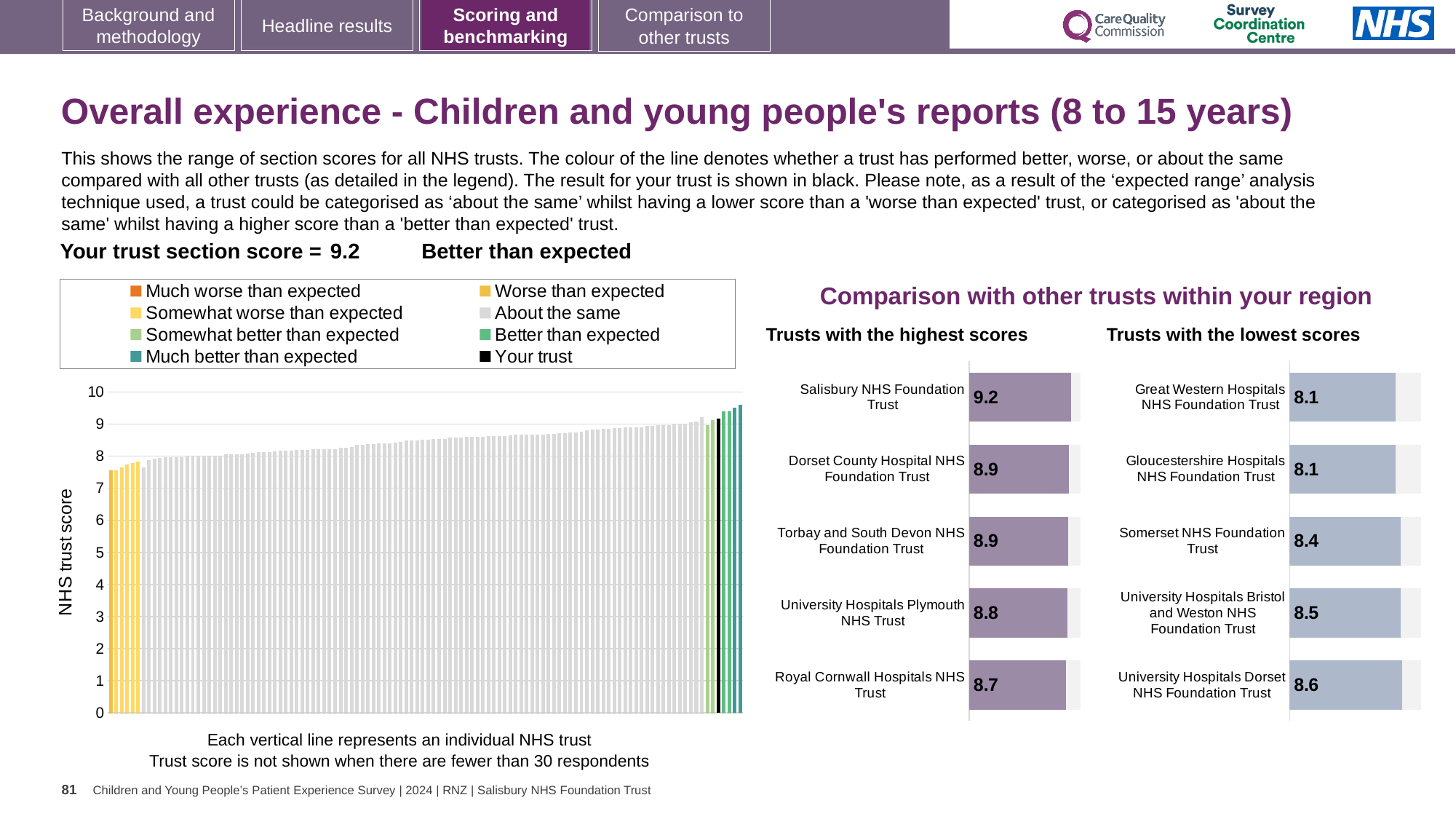
In the 'Trusts with the lowest scores' chart, how many trusts are shown? 5 In the 'Trusts with the lowest scores' chart, which has the larger score: Somerset NHS Foundation Trust or University Hospitals Bristol and Weston NHS Foundation Trust? University Hospitals Bristol and Weston NHS Foundation Trust In the 'Trusts with the highest scores' chart, what is the score for Salisbury NHS Foundation Trust? 9.2 How many entries does the legend above the NHS trust score chart list? 8 In the NHS trust score chart on the left, is the value of the leftmost (lowest) bar greater or less than 8? less In the 'Trusts with the highest scores' chart, which trust has the lowest score? Royal Cornwall Hospitals NHS Trust In the 'Trusts with the highest scores' chart, what is the difference between the scores of Salisbury NHS Foundation Trust and Royal Cornwall Hospitals NHS Trust? 0.5 What kind of chart is the NHS trust score chart on the left? Bar chart In the NHS trust score chart on the left, is the value for the black 'Your trust' bar greater or less than 9? greater In the 'Trusts with the lowest scores' chart, what is the score for Somerset NHS Foundation Trust? 8.4 In the 'Trusts with the lowest scores' chart, which trust has the highest score? University Hospitals Dorset NHS Foundation Trust In the 'Trusts with the highest scores' chart, what is the score for Royal Cornwall Hospitals NHS Trust? 8.7